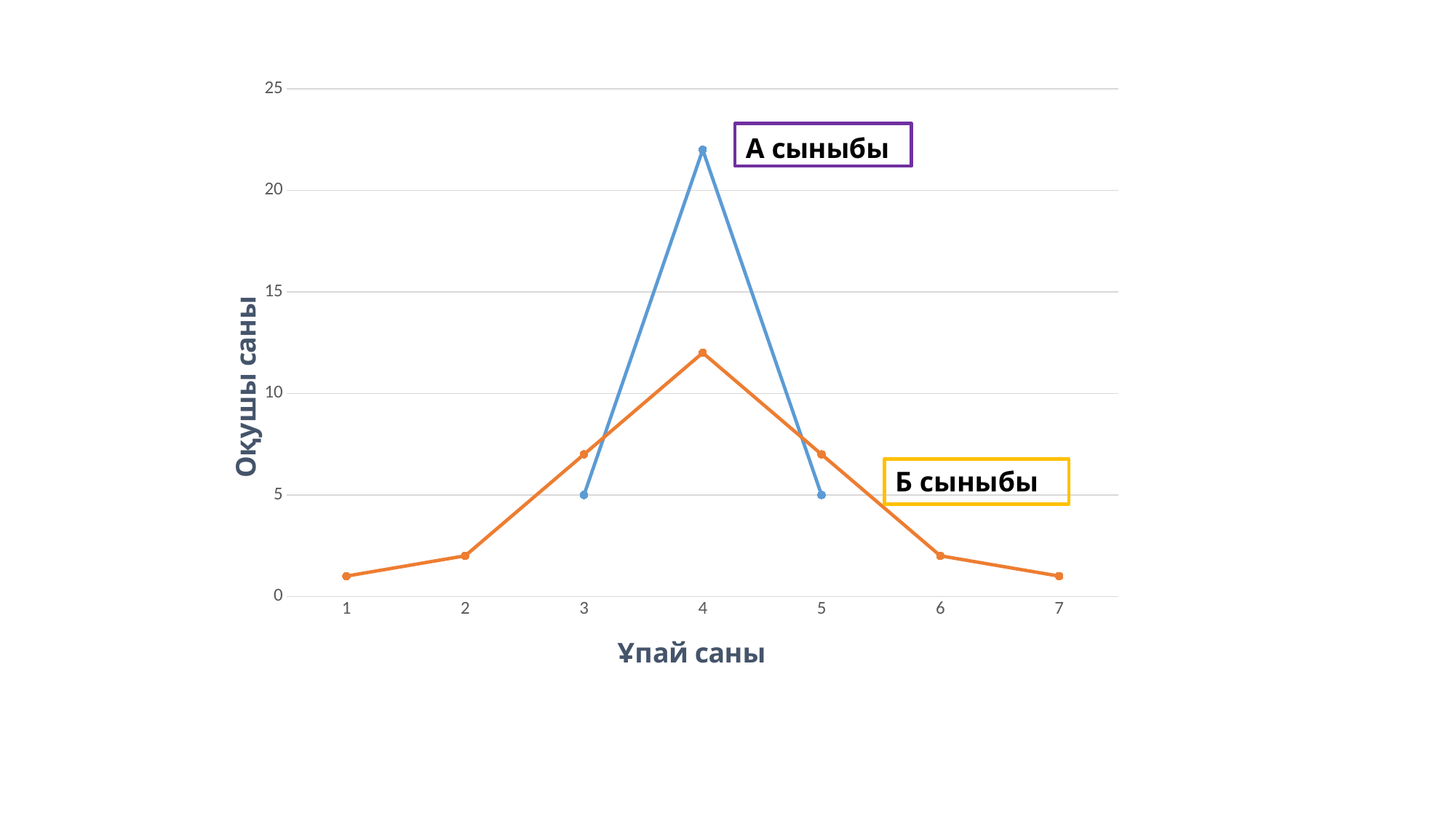
Is the value of the Б сыныбы line at Ұпай саны 1 greater or less than 5? less At Ұпай саны 3, which series has the higher value, А сыныбы or Б сыныбы? Б сыныбы How many values are marked on the x axis (Ұпай саны)? 7 What is the title of the vertical axis? Оқушы саны What is the value of the А сыныбы line at Ұпай саны 5? 5 Is the value of the А сыныбы line at Ұпай саны 4 greater or less than 20? greater At which Ұпай саны value does the Б сыныбы line reach its highest point? 4 At Ұпай саны 4, which series has the higher value, А сыныбы or Б сыныбы? А сыныбы How many data series (lines) are plotted on the chart? 2 What is the value of the А сыныбы line at Ұпай саны 3? 5 What kind of chart is shown on the slide? line chart Is the value of the Б сыныбы line at Ұпай саны 4 greater or less than 10? greater